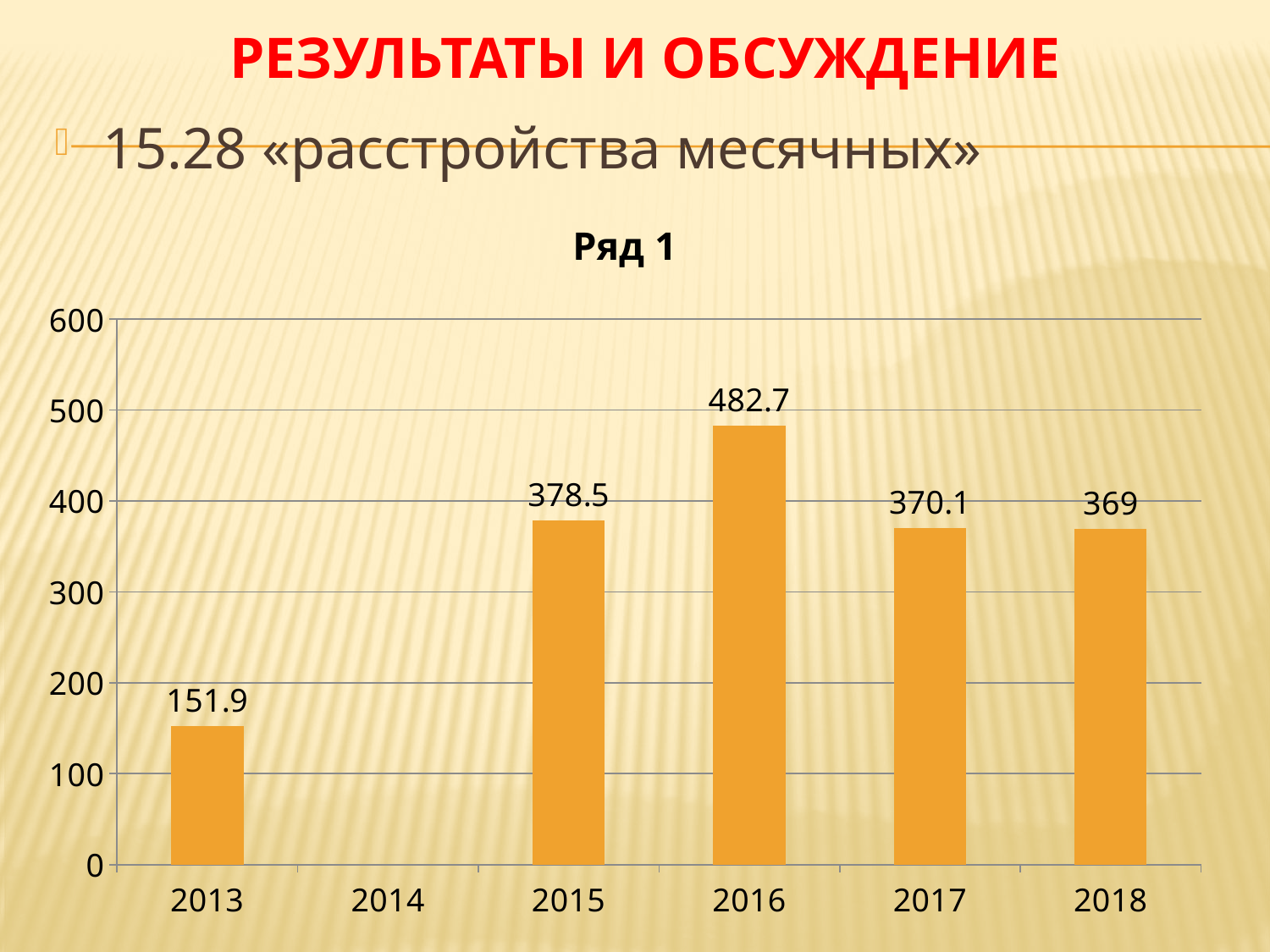
What is the value for 2013? 151.9 What is the difference between the values for 2016 and 2015? 104.2 How many years are shown on the x axis? 6 Is the value for 2016 greater or less than 400? greater What is the value for 2016? 482.7 Which is larger, the value for 2015 or the value for 2017? 2015 What is the title of the chart? Ряд 1 What is the difference between the values for 2017 and 2013? 218.2 Which year has the highest value? 2016 Which year with a plotted bar has the lowest value? 2013 What is the value for 2018? 369 What kind of chart is shown? bar chart